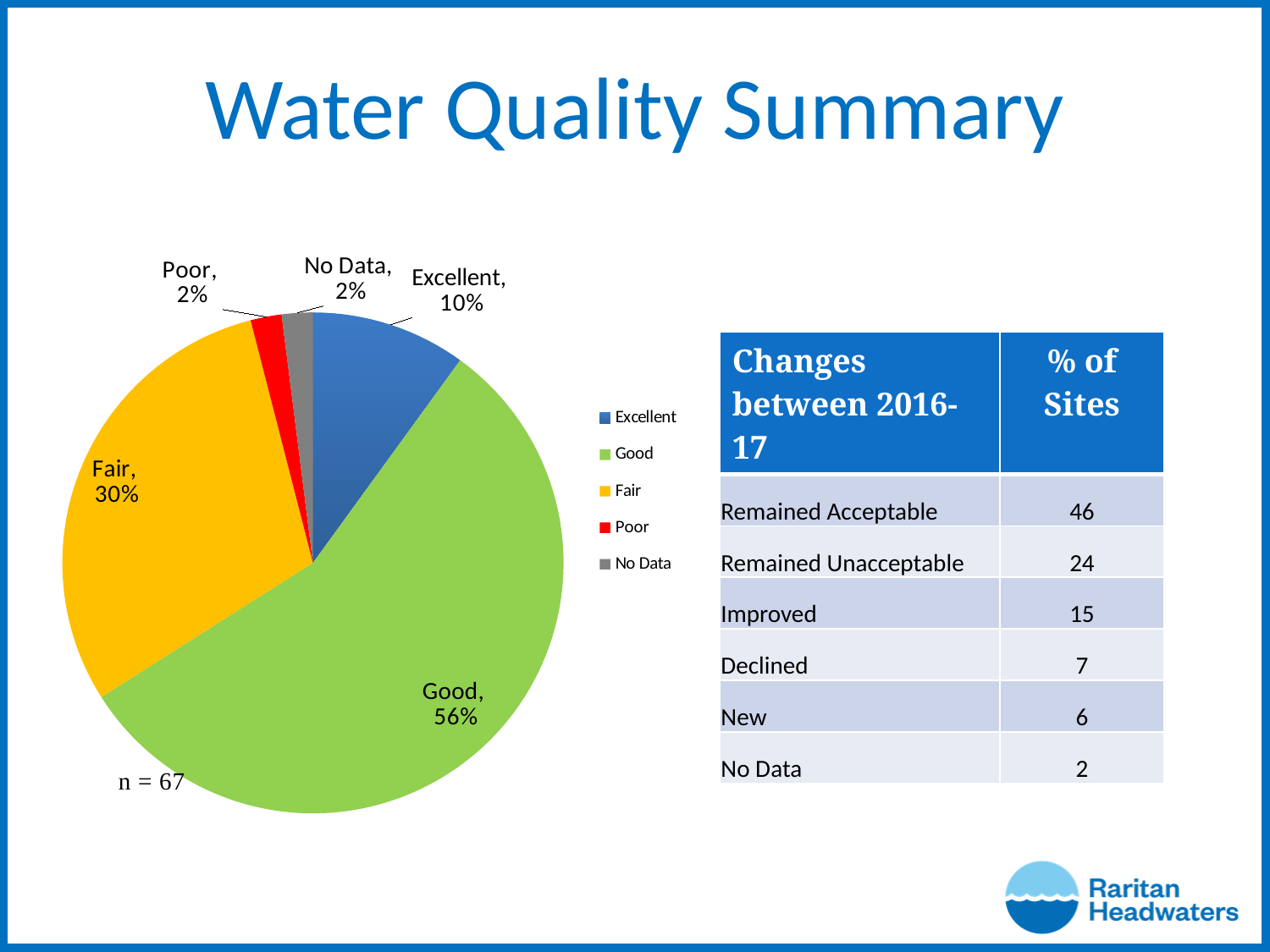
What colour is the Good slice in the pie chart? Green What percentage is shown for the Poor slice of the pie chart? 2% What is the value shown for the Excellent slice in the pie chart? 10% How many entries does the legend of the pie chart list? 5 What is the difference in percentage points between the Good and Fair slices of the pie chart? 26 What kind of chart is shown on the left of the slide? Pie chart What percentage does the Fair slice of the pie chart show? 30% How many slices does the pie chart have? 5 Which category has the largest slice in the pie chart? Good Which slice is larger in the pie chart, Fair or Excellent? Fair What share of the pie chart is labelled Good? 56% What sample size (n) is noted below the pie chart? n = 67